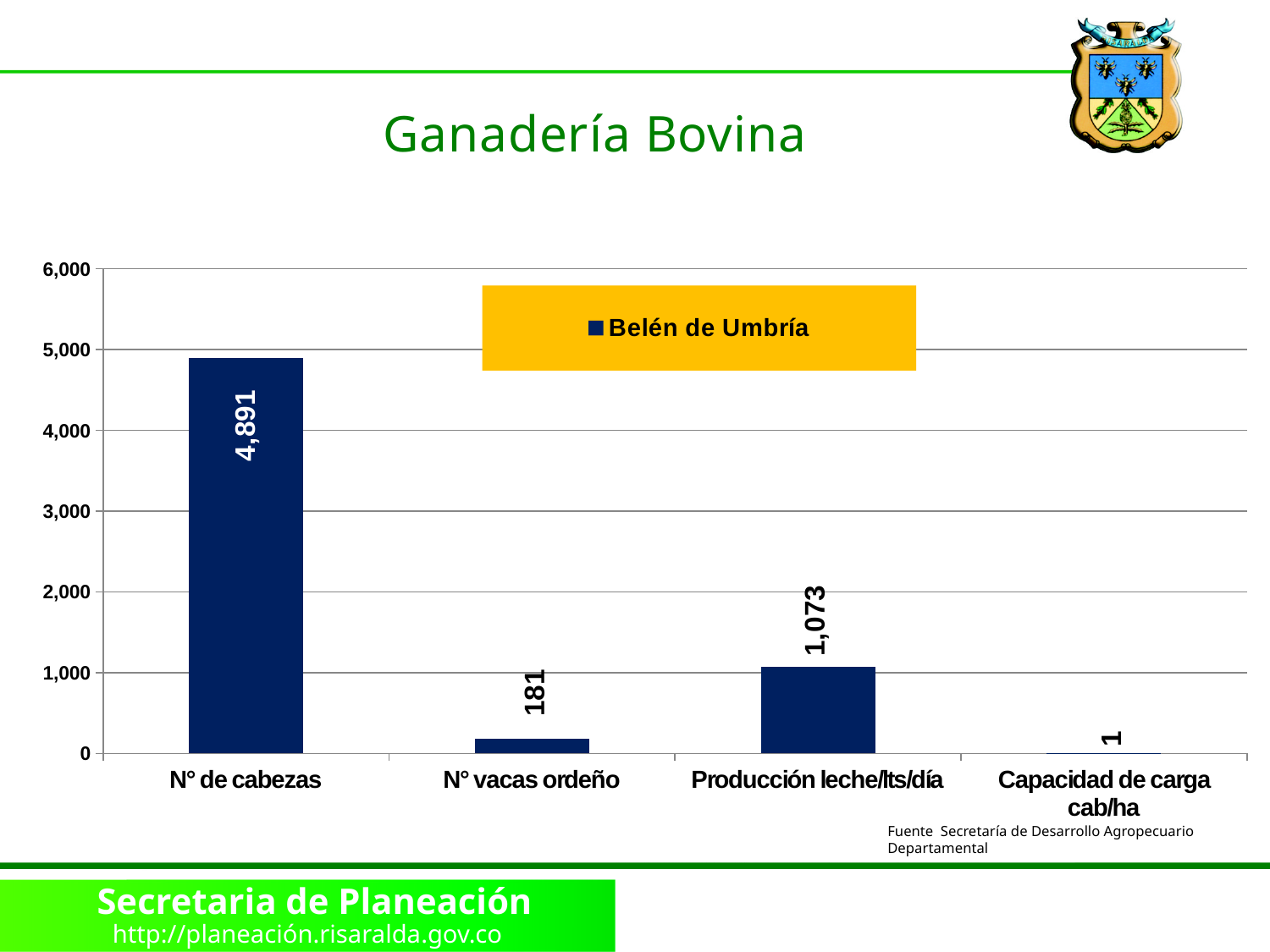
Which category has the lowest value? Capacidad de carga cab/ha What is the value for Producción leche/lts/día? 1,073 Which category has the highest value? N° de cabezas Is the value for N° de cabezas greater or less than 4,000? greater What is the difference between N° de cabezas and Producción leche/lts/día? 3,818 What is the value for N° de cabezas? 4,891 What is the value for Capacidad de carga cab/ha? 1 What is the value for N° vacas ordeño? 181 How many categories are shown on the x axis? 4 Which is larger, N° vacas ordeño or Producción leche/lts/día? Producción leche/lts/día What kind of chart is shown? bar chart How many series does the legend list? 1